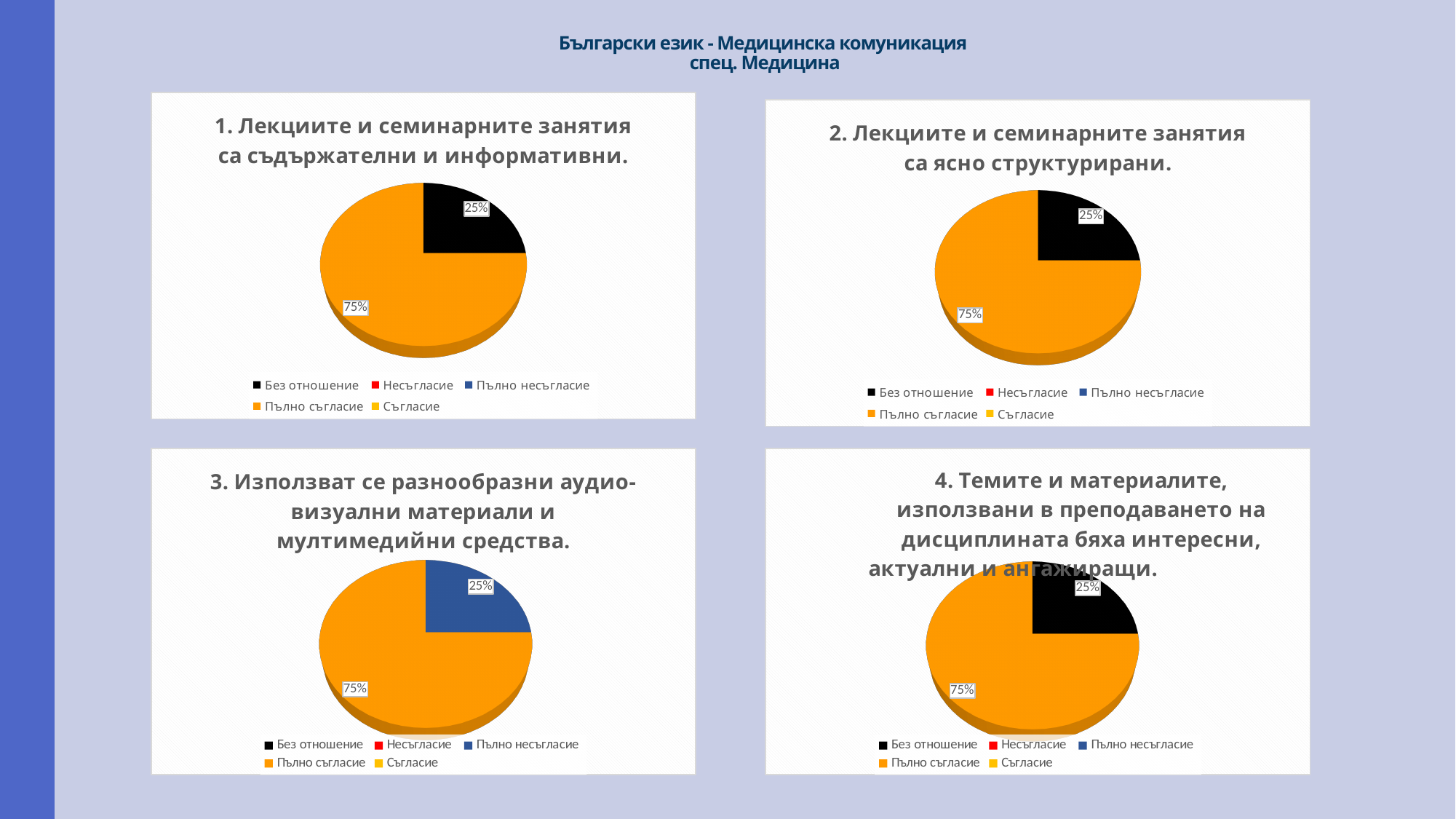
What kind of chart is the top-left chart on the slide? Pie chart In the chart titled "3. Използват се разнообразни аудио-визуални материали и мултимедийни средства.", what is the difference between the "Пълно съгласие" slice and the "Пълно несъгласие" slice? 50% In the chart titled "1. Лекциите и семинарните занятия са съдържателни и информативни.", what share of the pie is "Пълно съгласие"? 75% In the chart titled "4. Темите и материалите, използвани в преподаването на дисциплината бяха интересни, актуални и ангажиращи.", which is larger: "Без отношение" or "Пълно съгласие"? Пълно съгласие In the chart titled "4. Темите и материалите, използвани в преподаването на дисциплината бяха интересни, актуални и ангажиращи.", what share of the pie is "Пълно съгласие"? 75% In the chart titled "2. Лекциите и семинарните занятия са ясно структурирани.", what is the value shown for "Без отношение"? 25% In the chart titled "1. Лекциите и семинарните занятия са съдържателни и информативни.", what share of the pie is "Без отношение"? 25% How many pie charts are shown on the slide? 4 In the chart titled "3. Използват се разнообразни аудио-визуални материали и мултимедийни средства.", what colour is the "Пълно несъгласие" slice? Blue In the chart titled "3. Използват се разнообразни аудио-визуални материали и мултимедийни средства.", which category has the 25% slice? Пълно несъгласие How many entries does the legend of the chart titled "2. Лекциите и семинарните занятия са ясно структурирани." list? 5 In the chart titled "2. Лекциите и семинарните занятия са ясно структурирани.", which category has the largest slice? Пълно съгласие